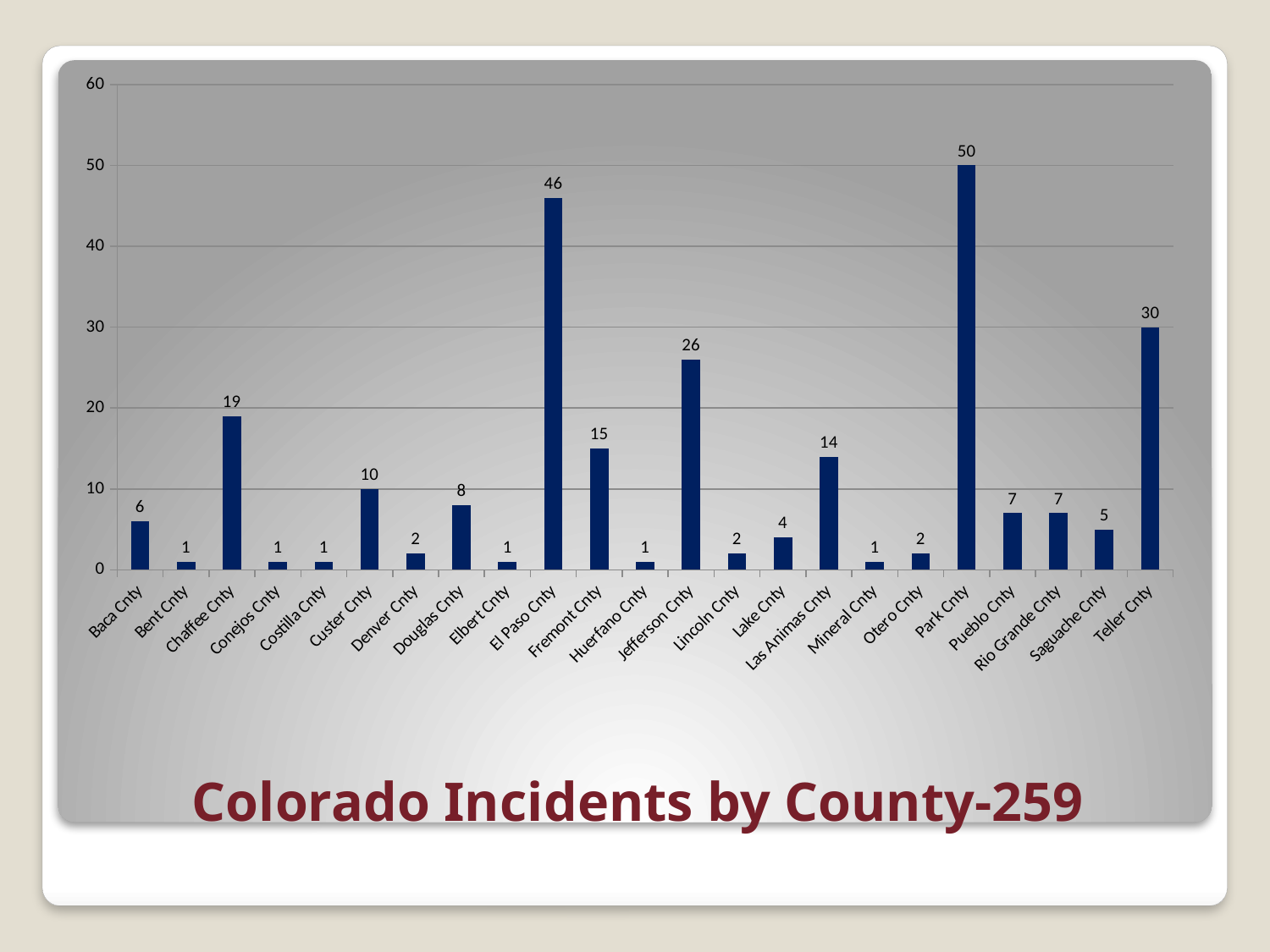
What is the value for Chaffee Cnty? 19 Is the value for Teller Cnty greater or less than 20? greater How many counties are shown on the x axis? 23 Which county has the highest value? Park Cnty What is the title of the chart? Colorado Incidents by County-259 What is the value for Las Animas Cnty? 14 What is the difference between the values for Teller Cnty and Fremont Cnty? 15 What is the difference between the values for Park Cnty and El Paso Cnty? 4 What is the value for Jefferson Cnty? 26 What is the value for El Paso Cnty? 46 What kind of chart is shown on the slide? bar chart Which is larger, the value for Custer Cnty or the value for Douglas Cnty? Custer Cnty